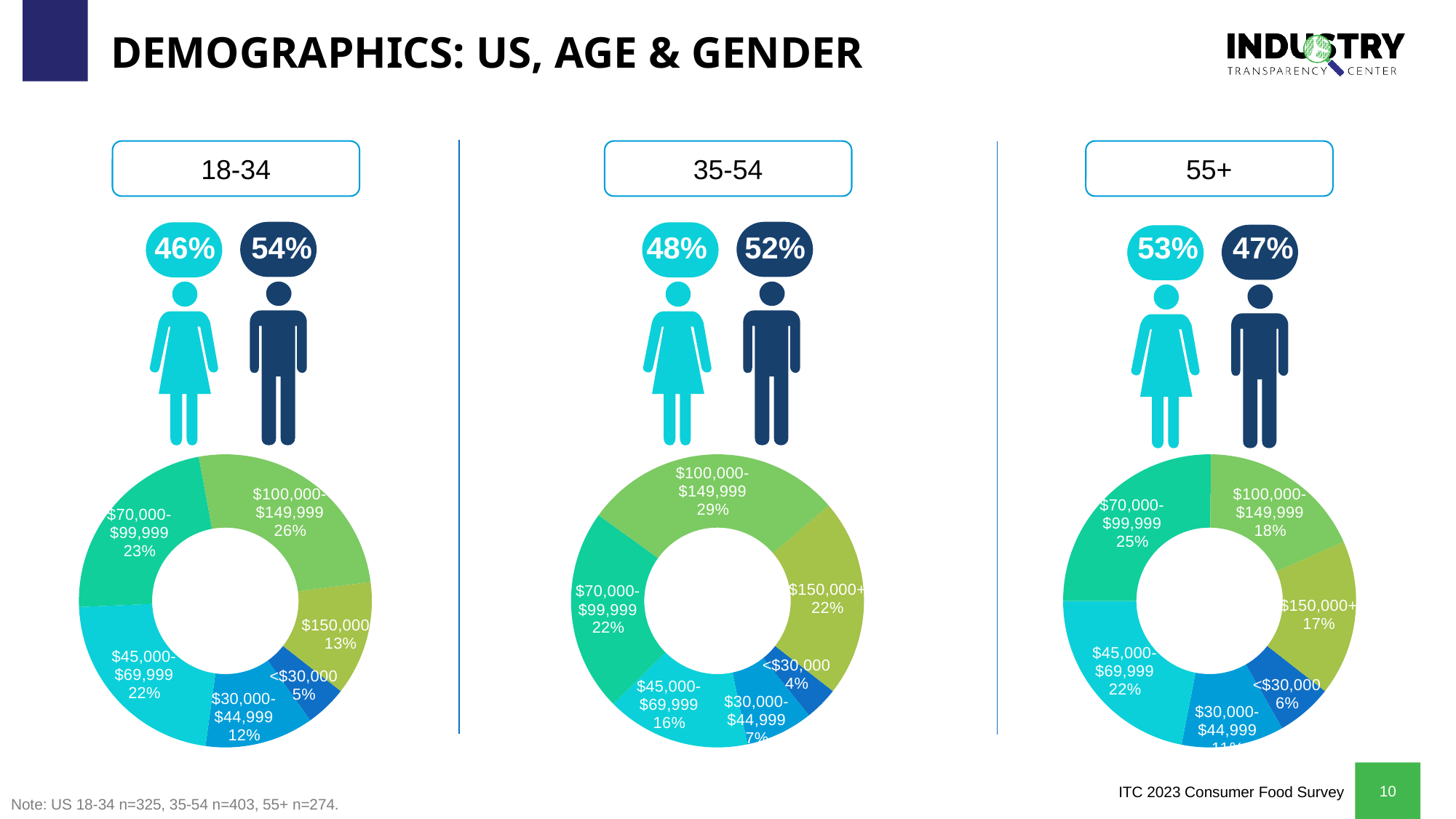
In the 18-34 donut chart, which income bracket has the smallest share? <$30,000 In the 18-34 donut chart, what is the difference between the $70,000-$99,999 share and the $45,000-$69,999 share? 1% In the 35-54 donut chart, which income bracket has the largest share? $100,000-$149,999 How many donut charts are on the slide? 3 In the 55+ donut chart, what share of respondents earn $70,000-$99,999? 25% How many income brackets are shown in the 18-34 donut chart? 6 In the 55+ donut chart, which income bracket has the smallest share? <$30,000 What type of chart is used to show income distribution for each age group? Donut chart In the 55+ donut chart, what is the difference between the $100,000-$149,999 share and the $150,000+ share? 1% In the 18-34 donut chart, what share of respondents earn $100,000-$149,999? 26% In the 35-54 donut chart, which is larger: the $70,000-$99,999 share or the $45,000-$69,999 share? $70,000-$99,999 In the 35-54 donut chart, what share of respondents earn $150,000+? 22%